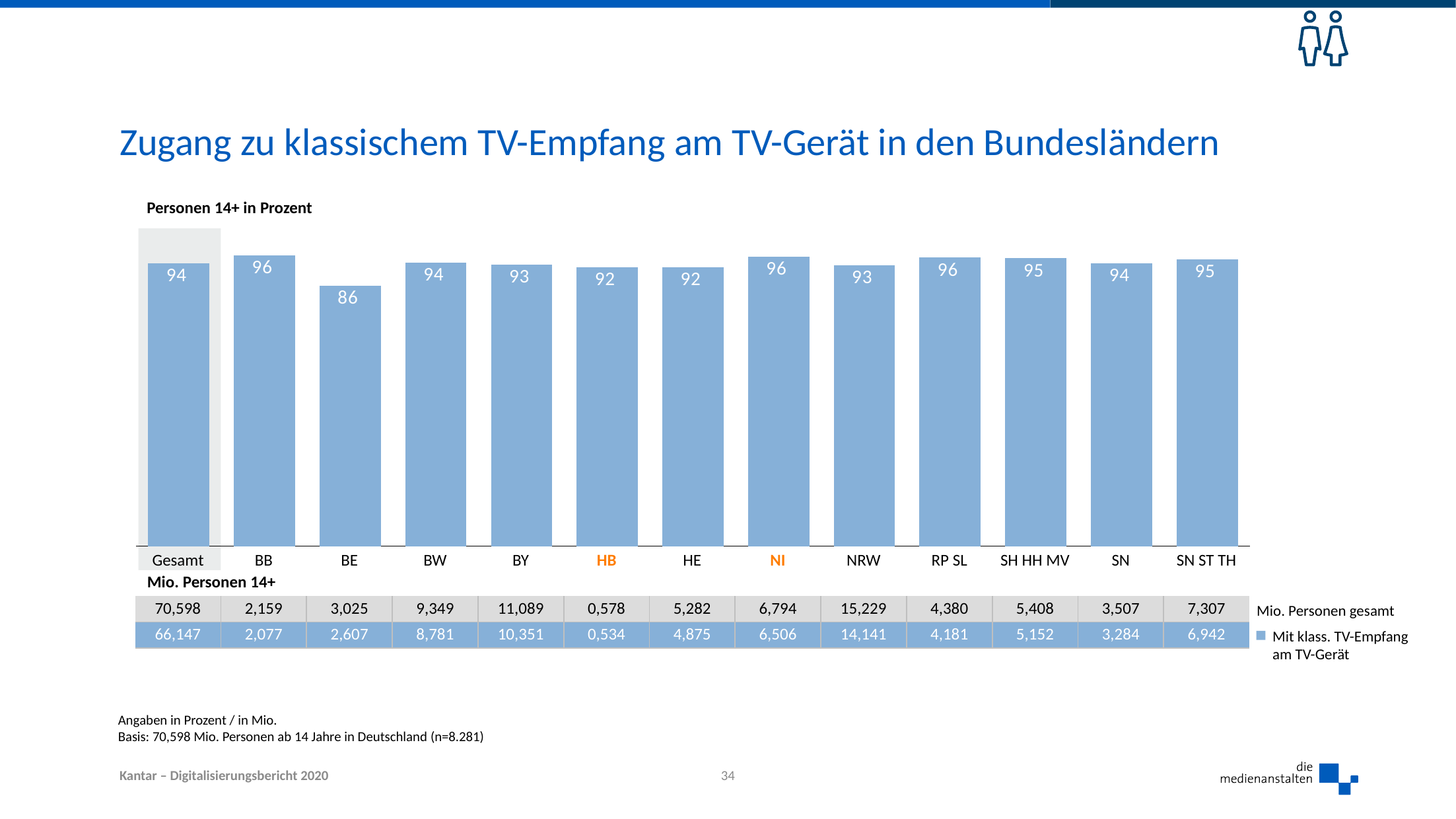
In the table below the chart, how many Mio. Personen gesamt are listed for BY? 11,089 Which category has the lowest value in the bar chart? BE What is the difference between the values for BB and BE in the bar chart? 10 How many categories are shown on the x axis of the bar chart? 13 In the table below the chart, what is the value for 'Mit klass. TV-Empfang am TV-Gerät' for NRW? 14,141 What is the value for Gesamt in the bar chart? 94 What is the value for BE in the bar chart? 86 What is the value for SH HH MV in the bar chart? 95 What is the title of the slide's chart? Zugang zu klassischem TV-Empfang am TV-Gerät in den Bundesländern What is the value for NRW in the bar chart? 93 What kind of chart is shown on the slide? bar chart Which has the larger value in the bar chart, HB or NI? NI